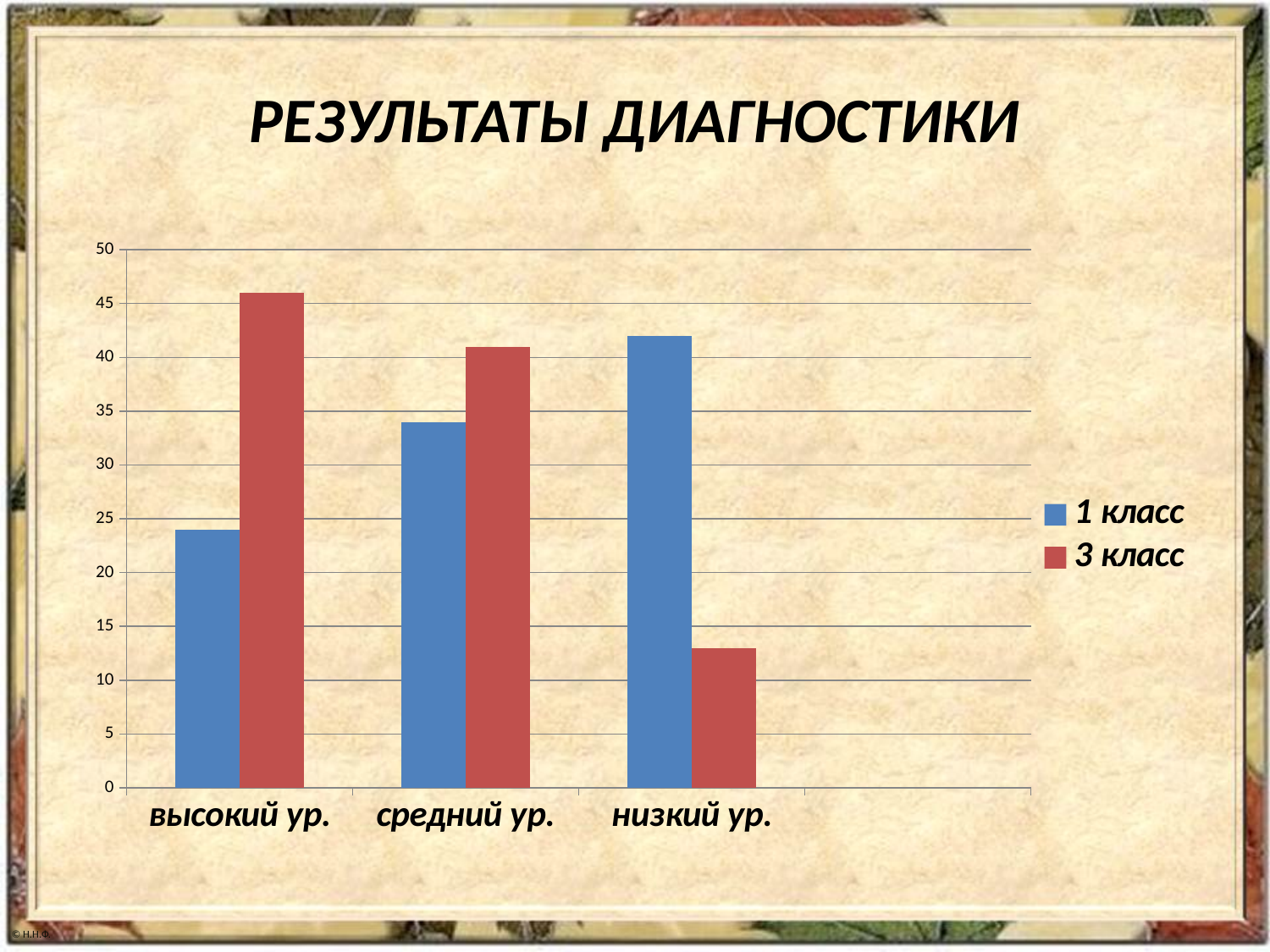
For низкий ур., which series has the larger value, 1 класс or 3 класс? 1 класс How many categories are shown on the x axis? 3 Is the value for 3 класс at низкий ур. greater or less than 15? less Is the value for 3 класс at высокий ур. greater or less than 40? greater How many series does the legend list? 2 For высокий ур., which series has the larger value, 1 класс or 3 класс? 3 класс Is the value for 1 класс at средний ур. greater or less than 30? greater Which series is shown in red? 3 класс Which category has the highest value for the 1 класс series? низкий ур. Which category has the lowest value for the 3 класс series? низкий ур. What is the title of the chart? РЕЗУЛЬТАТЫ ДИАГНОСТИКИ What kind of chart is shown on the slide? bar chart